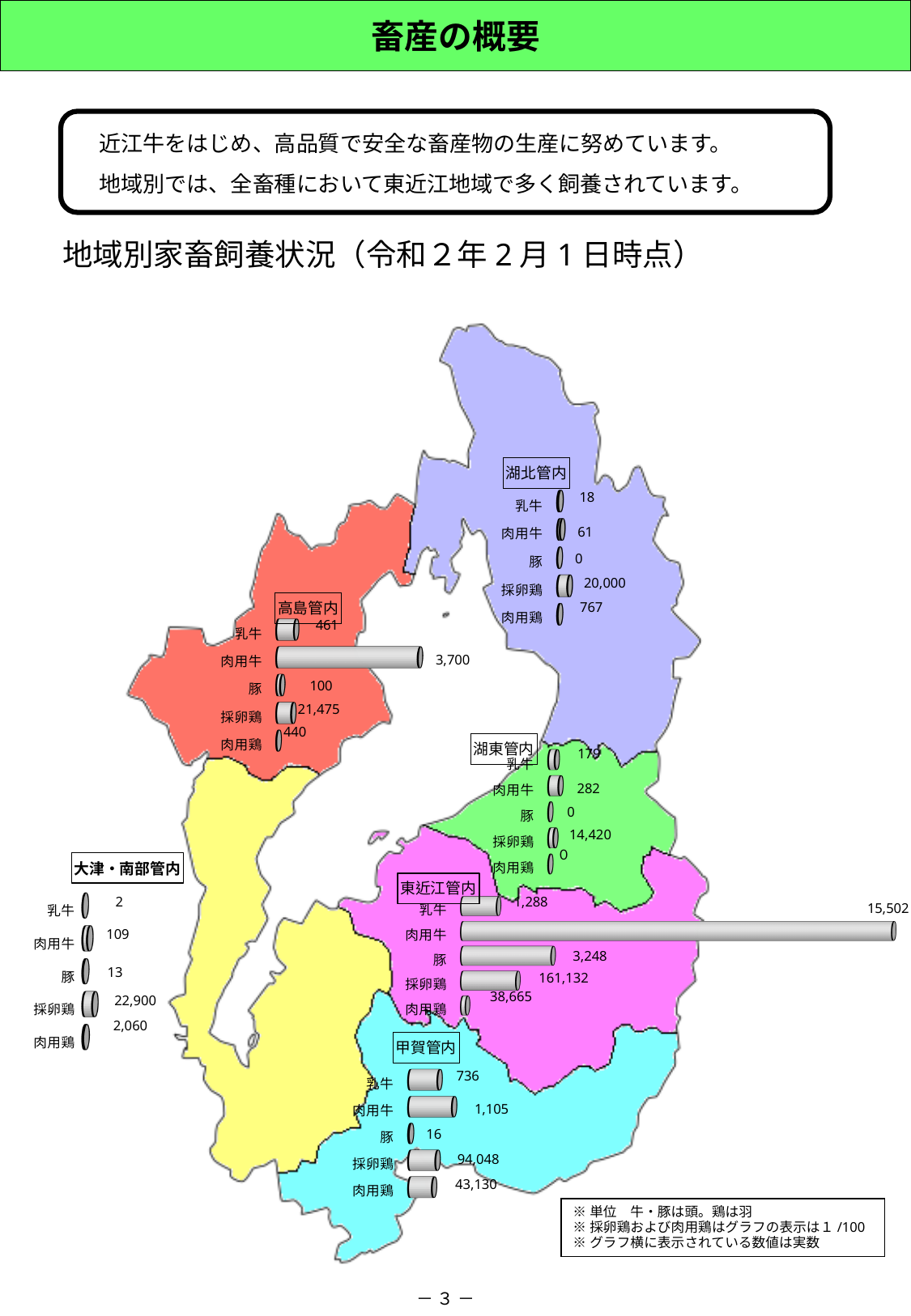
What kind of chart is used for each region on the slide? bar chart In the 大津・南部管内 chart, which category has the highest value? 採卵鶏 In the 湖北管内 chart, what is the difference between the values for 肉用牛 and 乳牛? 43 In the 東近江管内 chart, what is the value for 肉用牛? 15,502 How many regional charts are shown on the map? 6 In the 東近江管内 chart, what is the difference between the values for 肉用牛 and 乳牛? 14,214 In the 湖北管内 chart, what is the value for 豚? 0 In the 高島管内 chart, what is the value for 採卵鶏? 21,475 In the 甲賀管内 chart, which is larger, the value for 乳牛 or the value for 肉用牛? 肉用牛 In the 湖東管内 chart, which category has the lowest value among 乳牛, 肉用牛 and 採卵鶏? 乳牛 In the 甲賀管内 chart, what is the value for 肉用鶏? 43,130 How many categories are shown in the 高島管内 chart? 5